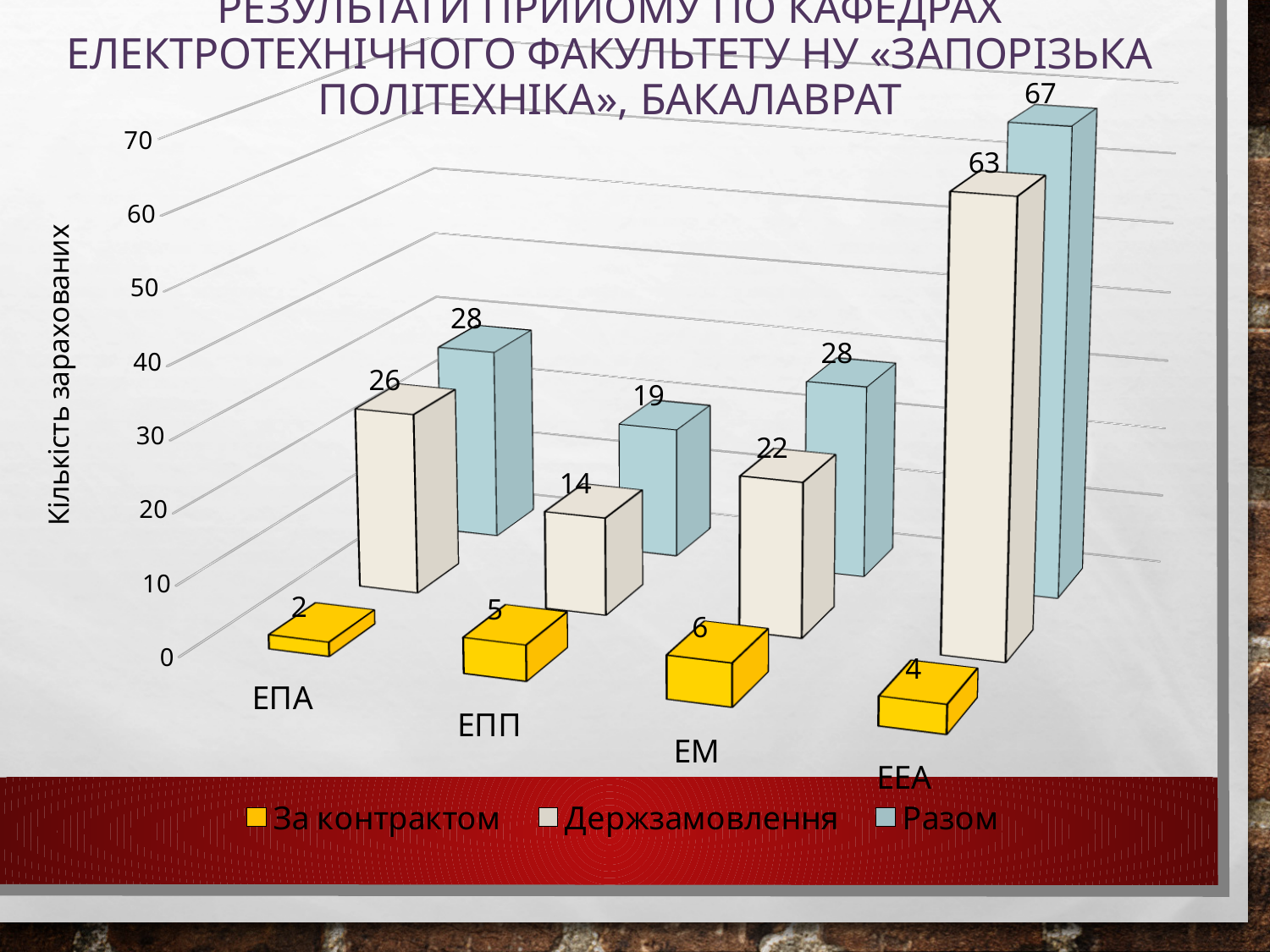
Which category has the highest Разом value? ЕЕА What is the difference between the Разом values for ЕЕА and ЕПА? 39 What is the difference between Держзамовлення and За контрактом for ЕПП? 9 What is the value of За контрактом for ЕМ? 6 Which is larger: Держзамовлення for ЕПА or Держзамовлення for ЕМ? ЕПА What colour are the bars for the series Разом? light blue Which category has the lowest За контрактом value? ЕПА What is the value of Разом for ЕПП? 19 What kind of chart is shown on the slide? bar chart How many categories are shown on the x axis? 4 How many series does the legend list? 3 What is the value of Держзамовлення for ЕЕА? 63